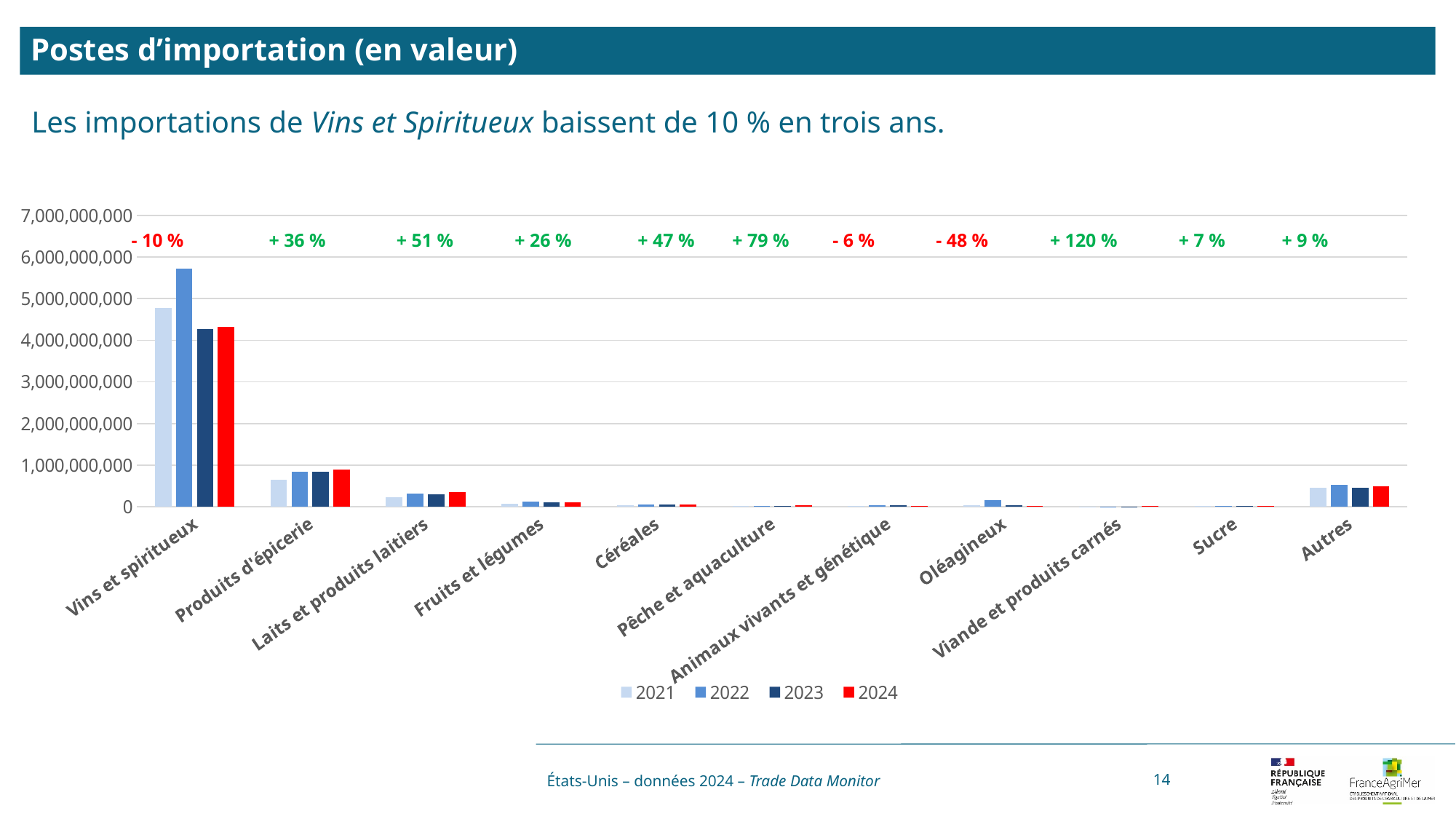
For Vins et spiritueux, which is larger: the 2021 value or the 2022 value? 2022 How many categories are shown on the x axis? 11 What percentage change is shown above Oléagineux? - 48 % Is the 2024 value for Vins et spiritueux greater or less than 5,000,000,000? less What kind of chart is shown on the slide? bar chart Is the 2022 value for Vins et spiritueux greater or less than 5,000,000,000? greater Is the 2024 value for Produits d'épicerie greater or less than 1,000,000,000? less What percentage change is shown above Viande et produits carnés? + 120 % Which category has the highest import values? Vins et spiritueux What are the entries in the chart legend? 2021, 2022, 2023, 2024 How many series does the legend list? 4 Which category shows the lowest percentage change label? Oléagineux